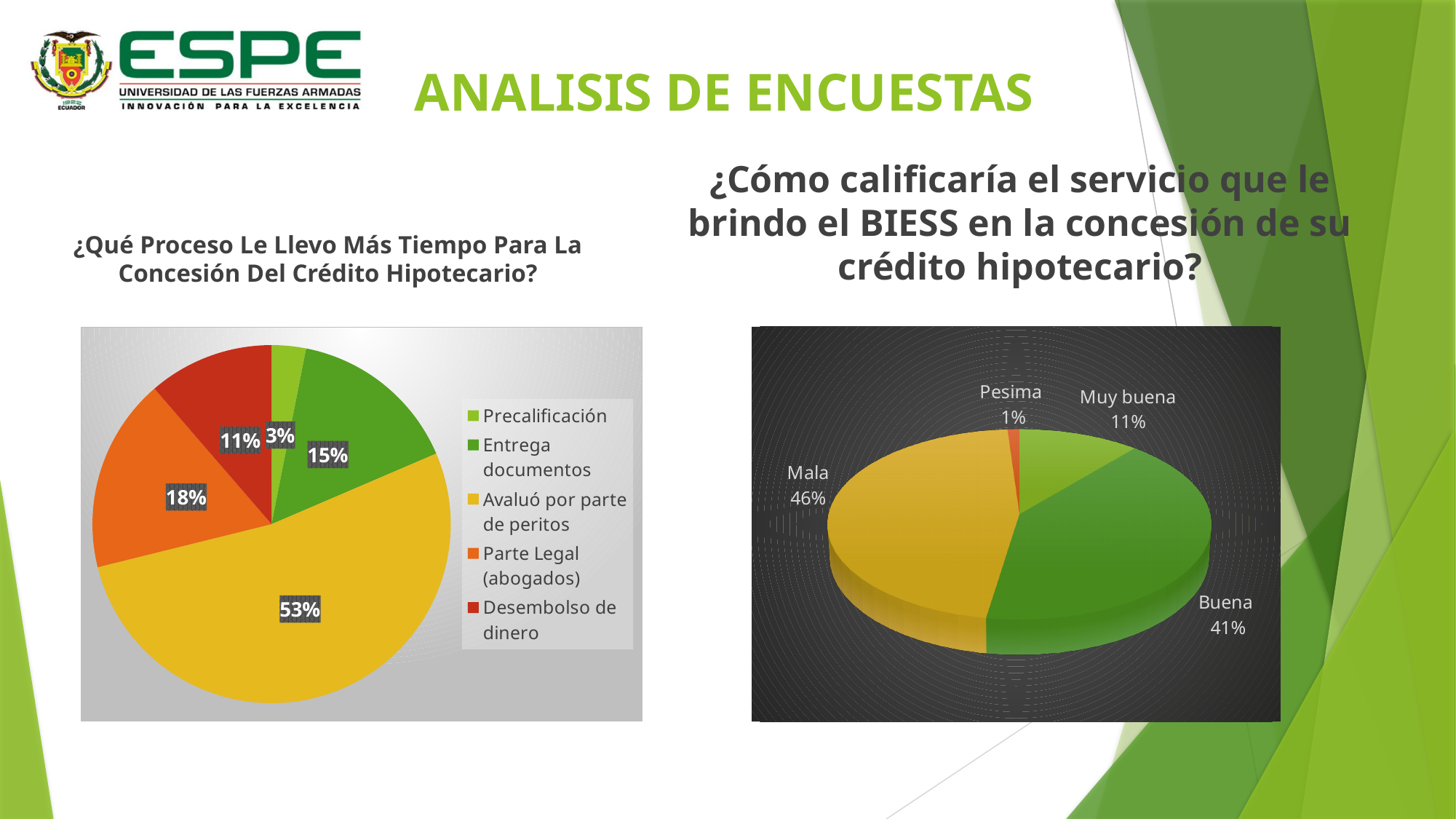
In the left chart (¿Qué Proceso Le Llevo Más Tiempo...?), which category has the smallest share? Precalificación In the right chart (¿Cómo calificaría el servicio...?), what share is shown for Mala? 46% In the left chart (¿Qué Proceso Le Llevo Más Tiempo...?), what share is shown for Parte Legal (abogados)? 18% What type of chart is the left chart (¿Qué Proceso Le Llevo Más Tiempo...?)? Pie chart In the right chart (¿Cómo calificaría el servicio...?), what is the difference in percentage points between Mala and Buena? 5 percentage points In the left chart (¿Qué Proceso Le Llevo Más Tiempo...?), what share is shown for Avaluó por parte de peritos? 53% In the right chart (¿Cómo calificaría el servicio...?), which is larger, Buena or Muy buena? Buena In the right chart (¿Cómo calificaría el servicio...?), what share is shown for Pesima? 1% In the left chart (¿Qué Proceso Le Llevo Más Tiempo...?), which category has the largest share? Avaluó por parte de peritos In the right chart (¿Cómo calificaría el servicio...?), how many slices does the pie have? 4 In the left chart (¿Qué Proceso Le Llevo Más Tiempo...?), how many categories does the legend list? 5 In the left chart (¿Qué Proceso Le Llevo Más Tiempo...?), what is the difference in percentage points between Entrega documentos and Desembolso de dinero? 4 percentage points